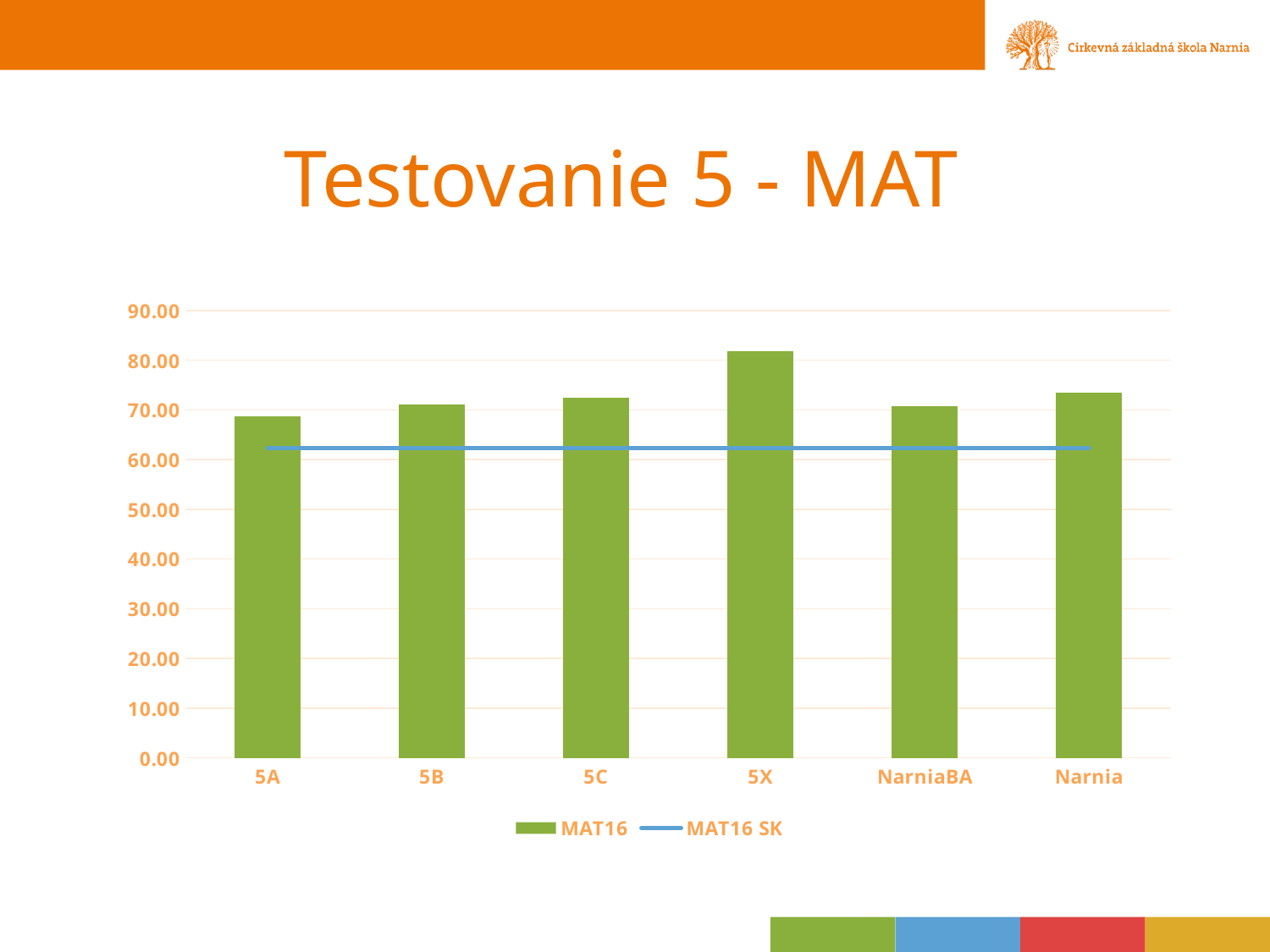
What is the title of the slide containing the chart? Testovanie 5 - MAT What kind of chart is shown on the slide? combination bar and line chart Is the MAT16 SK line greater or less than 60.00? greater How many categories are shown on the x axis of the chart? 6 Is the MAT16 value for 5C greater or less than 70.00? greater Which series is drawn as a line in the chart? MAT16 SK Is the MAT16 value for 5X greater or less than 80.00? greater Which has the larger MAT16 value, 5X or 5A? 5X Which category has the lowest MAT16 bar? 5A How many series does the legend list? 2 Which category has the highest MAT16 bar? 5X